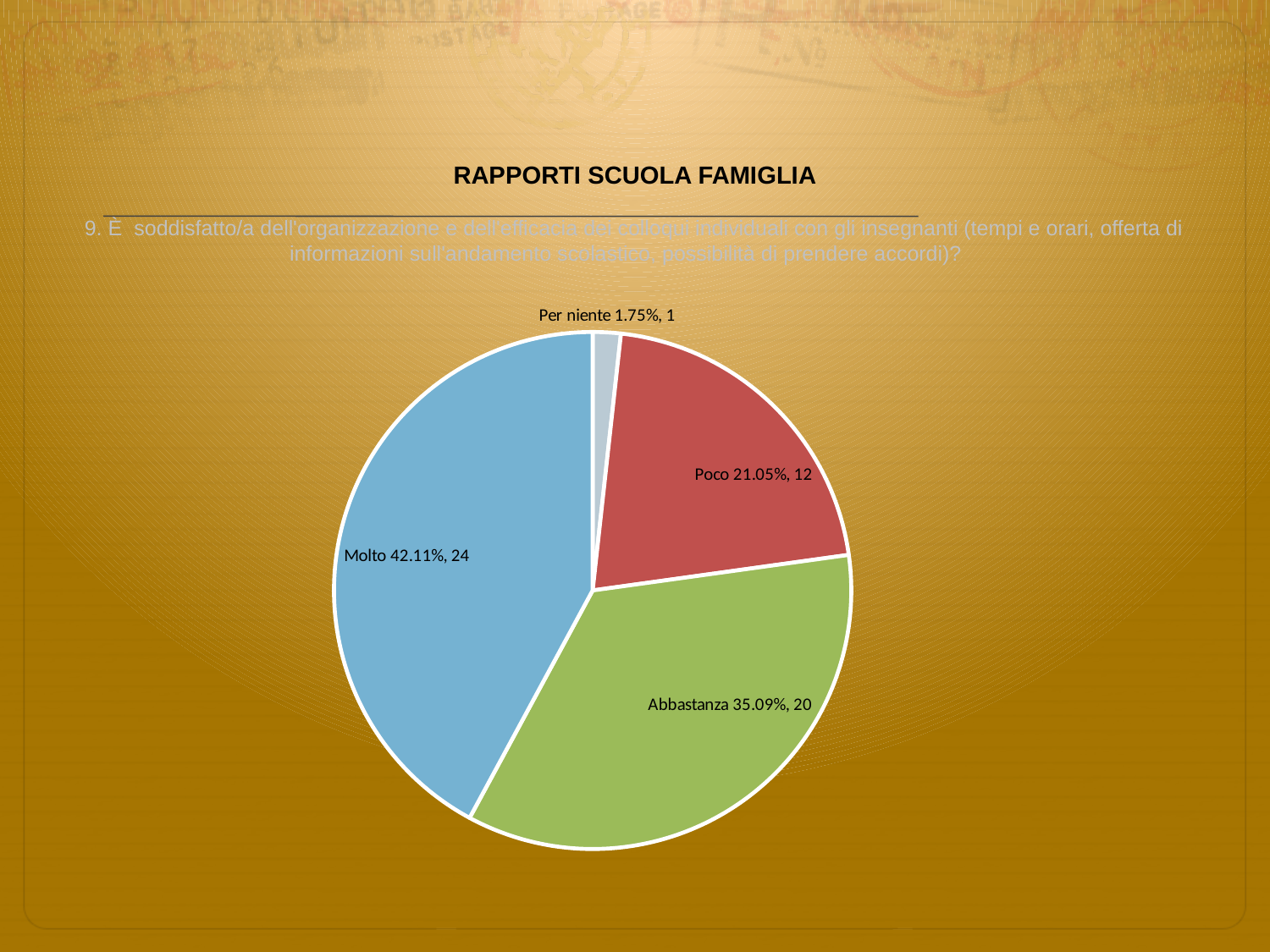
What is the difference in count between Molto and Abbastanza? 4 What percentage is shown for the Poco slice? 21.05% What is the total count across all slices of the pie? 57 Which category has the smallest slice of the pie? Per niente Which category has the largest slice of the pie? Molto Which is larger, the Poco slice or the Abbastanza slice? Abbastanza What kind of chart is shown on the slide? pie chart What count is shown for the Per niente slice? 1 What is the title shown above the chart? RAPPORTI SCUOLA FAMIGLIA How many slices does the pie chart have? 4 What percentage is shown for the Molto slice? 42.11% What count is shown for the Abbastanza slice? 20